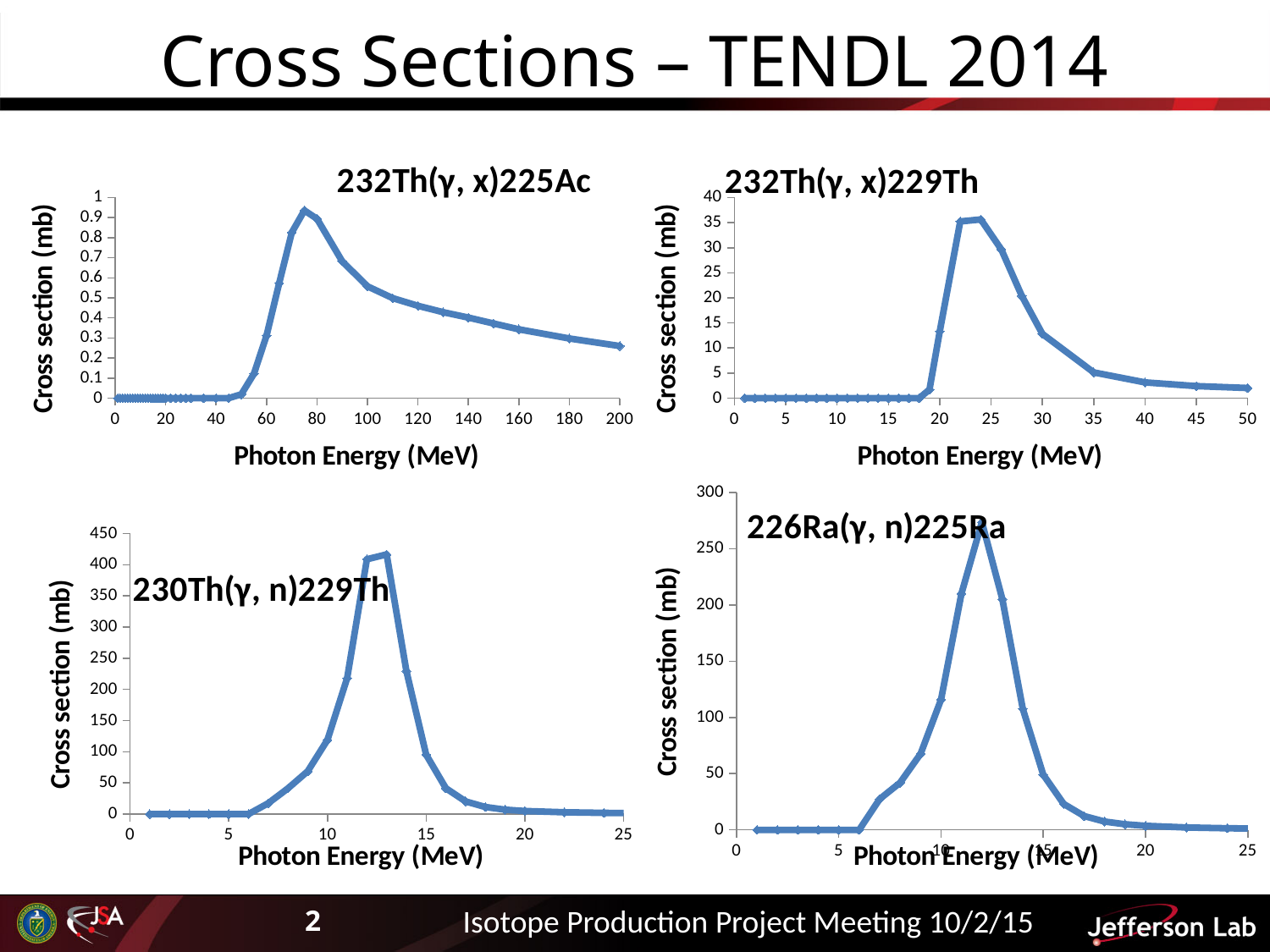
In the 232Th(γ, x)225Ac chart, is the cross section at 40 MeV greater or less than 0.1? less In the 230Th(γ, n)229Th chart, is the peak cross section greater or less than 350? greater What is the x-axis label on the 230Th(γ, n)229Th chart? Photon Energy (MeV) In the 232Th(γ, x)229Th chart, is the peak cross section greater or less than 30? greater What kind of chart is the 232Th(γ, x)225Ac chart? line chart In the 232Th(γ, x)225Ac chart, does the cross section rise or fall as photon energy increases from 80 MeV to 200 MeV? fall How many charts are shown on the slide? 4 What is the y-axis label on the 226Ra(γ, n)225Ra chart? Cross section (mb)